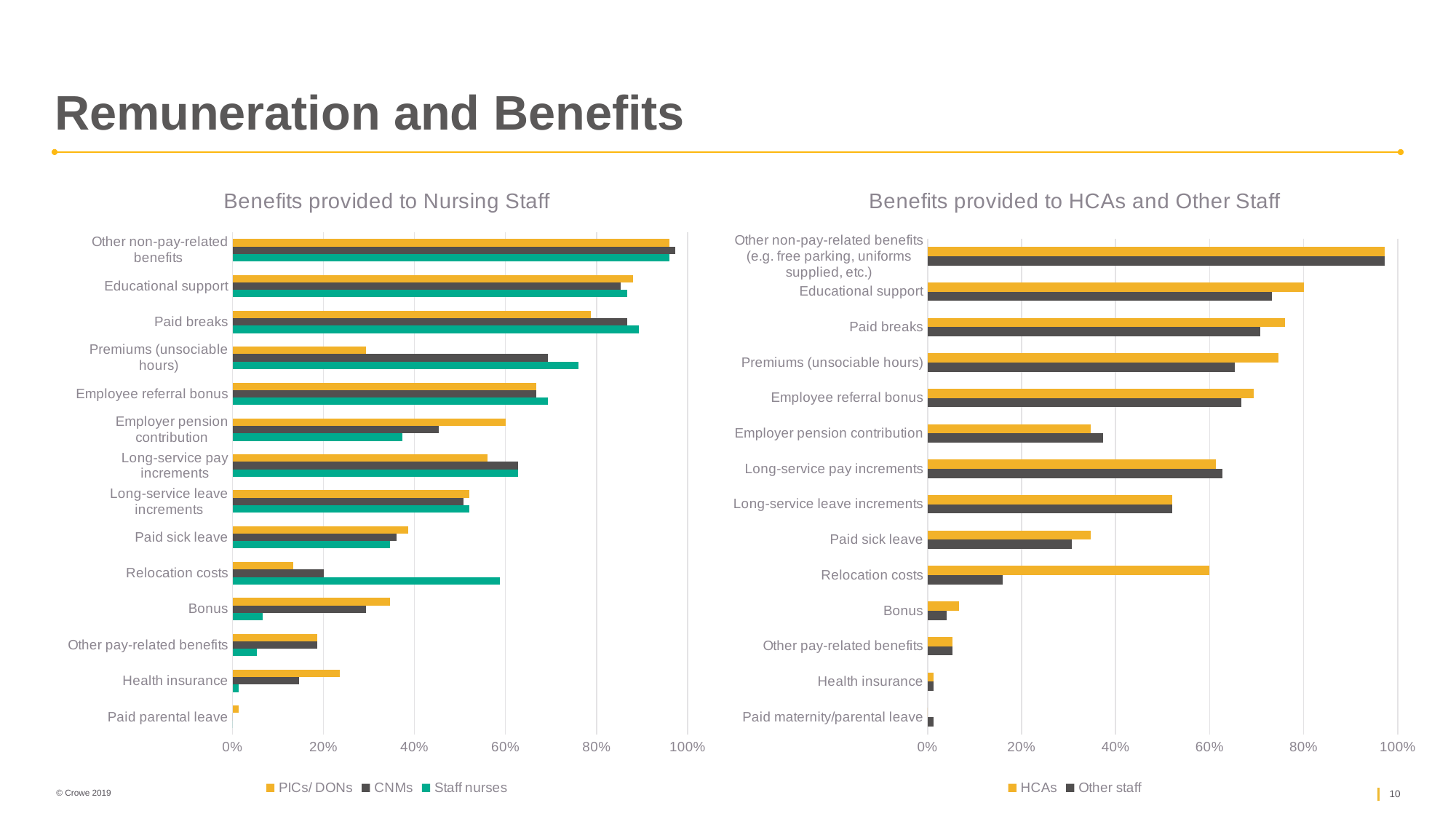
In the 'Benefits provided to Nursing Staff' chart, is the Staff nurses value for Paid breaks greater or less than 80%? greater What kind of chart is 'Benefits provided to Nursing Staff'? Bar chart How many benefit categories are shown in the 'Benefits provided to HCAs and Other Staff' chart? 14 In the 'Benefits provided to Nursing Staff' chart, which category has the lowest PICs/ DONs value? Paid parental leave How many series does the legend of the 'Benefits provided to HCAs and Other Staff' chart list? 2 In the 'Benefits provided to HCAs and Other Staff' chart, which is larger for Relocation costs: the HCAs value or the Other staff value? HCAs Which series in the 'Benefits provided to Nursing Staff' chart is shown in teal? Staff nurses In the 'Benefits provided to HCAs and Other Staff' chart, is the Other staff value for Relocation costs greater or less than 20%? less In the 'Benefits provided to Nursing Staff' chart, is the PICs/ DONs value for Premiums (unsociable hours) greater or less than 40%? less How many series does the legend of the 'Benefits provided to Nursing Staff' chart list? 3 In the 'Benefits provided to Nursing Staff' chart, which is larger for Relocation costs: the PICs/ DONs value or the Staff nurses value? Staff nurses